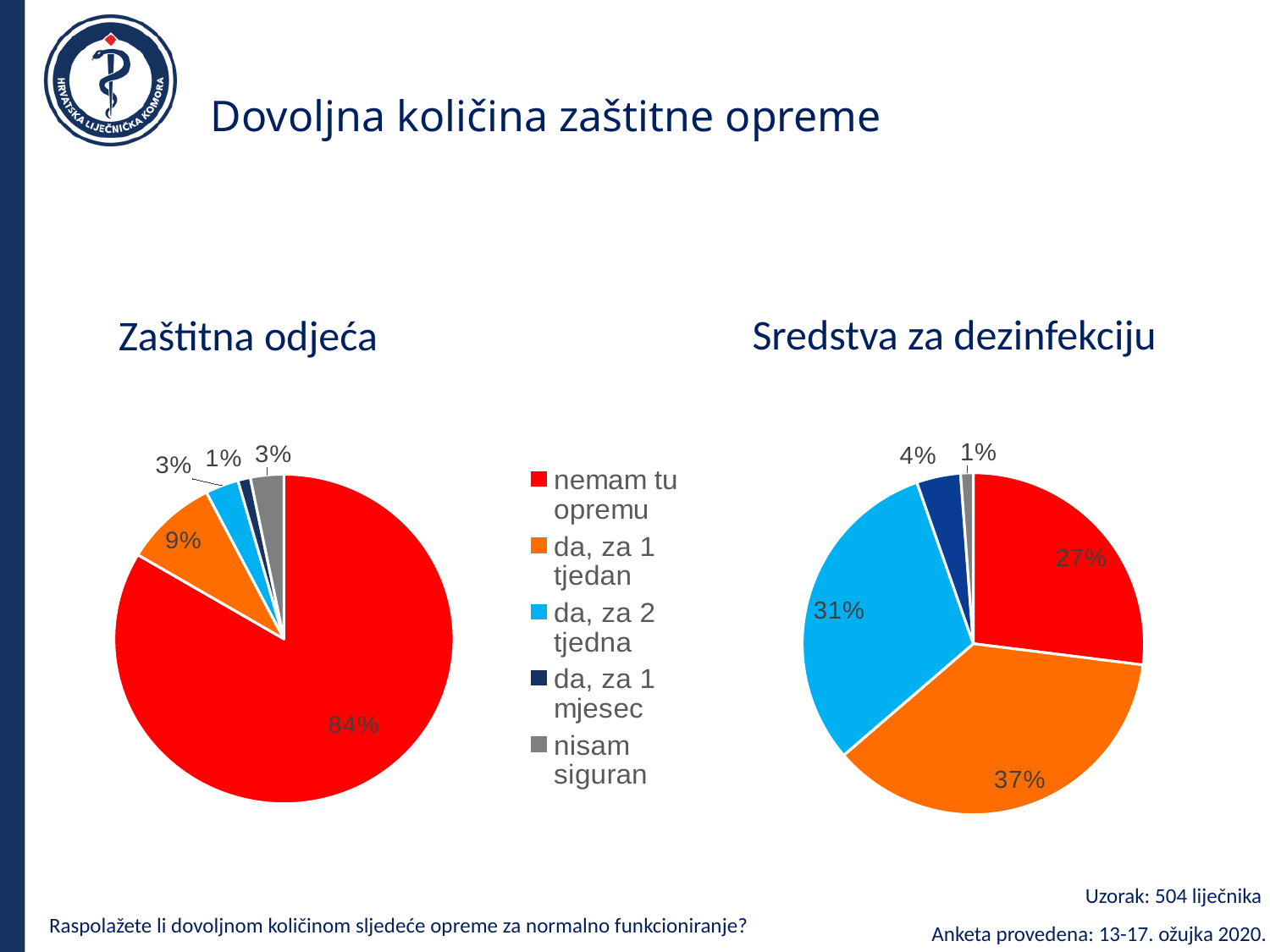
Which colour represents 'nisam siguran' in the legend? Gray In the 'Zaštitna odjeća' chart, which category has the largest slice? nemam tu opremu In the 'Sredstva za dezinfekciju' chart, what share is labelled for 'nemam tu opremu'? 27% In the 'Sredstva za dezinfekciju' chart, what share is labelled for 'da, za 2 tjedna'? 31% In the 'Zaštitna odjeća' chart, what share is labelled for 'da, za 1 tjedan'? 9% In the 'Zaštitna odjeća' chart, what share is labelled for 'nemam tu opremu'? 84% In the 'Sredstva za dezinfekciju' chart, what is the difference between the shares for 'da, za 1 tjedan' and 'nemam tu opremu'? 10 percentage points How many categories does the legend list? 5 In the 'Sredstva za dezinfekciju' chart, which category has the smallest slice? nisam siguran In the 'Sredstva za dezinfekciju' chart, which category has the largest slice? da, za 1 tjedan Which chart has the larger share for 'da, za 1 mjesec', 'Zaštitna odjeća' or 'Sredstva za dezinfekciju'? Sredstva za dezinfekciju What kind of charts are shown on the slide? Pie charts